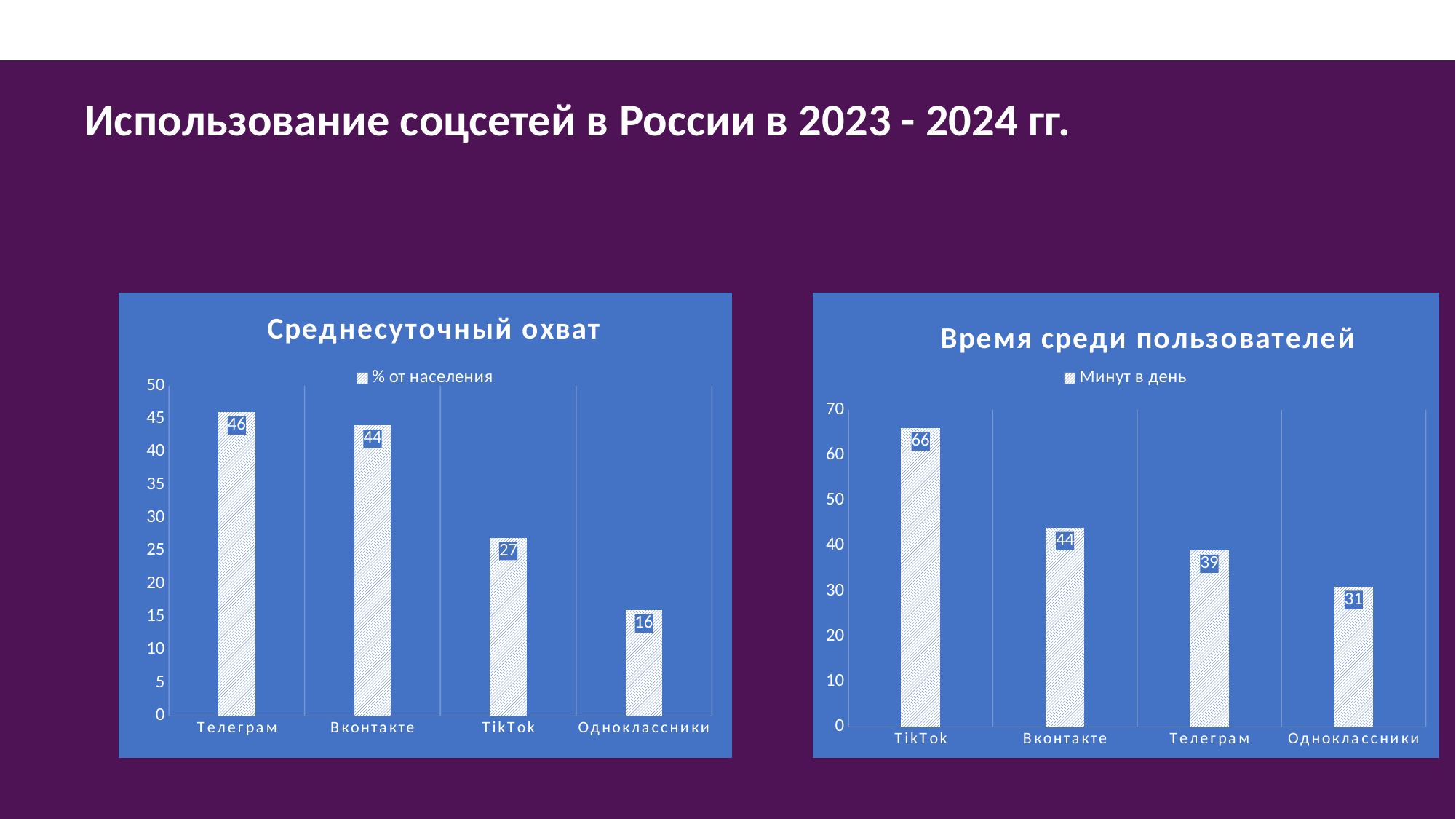
In the 'Время среди пользователей' chart, what is the value for Телеграм? 39 What is the legend entry in the 'Среднесуточный охват' chart? % от населения In the 'Время среди пользователей' chart, what is the difference between TikTok and Одноклассники? 35 In the 'Среднесуточный охват' chart, which category has the lowest value? Одноклассники In the 'Время среди пользователей' chart, which category has the highest value? TikTok In the 'Среднесуточный охват' chart, what is the difference between Вконтакте and TikTok? 17 In the 'Время среди пользователей' chart, what is the value for TikTok? 66 In the 'Среднесуточный охват' chart, what is the value for Телеграм? 46 In the 'Среднесуточный охват' chart, how many categories are shown? 4 In the 'Среднесуточный охват' chart, what is the value for Одноклассники? 16 In the 'Время среди пользователей' chart, which is larger, Вконтакте or Одноклассники? Вконтакте What kind of chart is 'Время среди пользователей'? bar chart